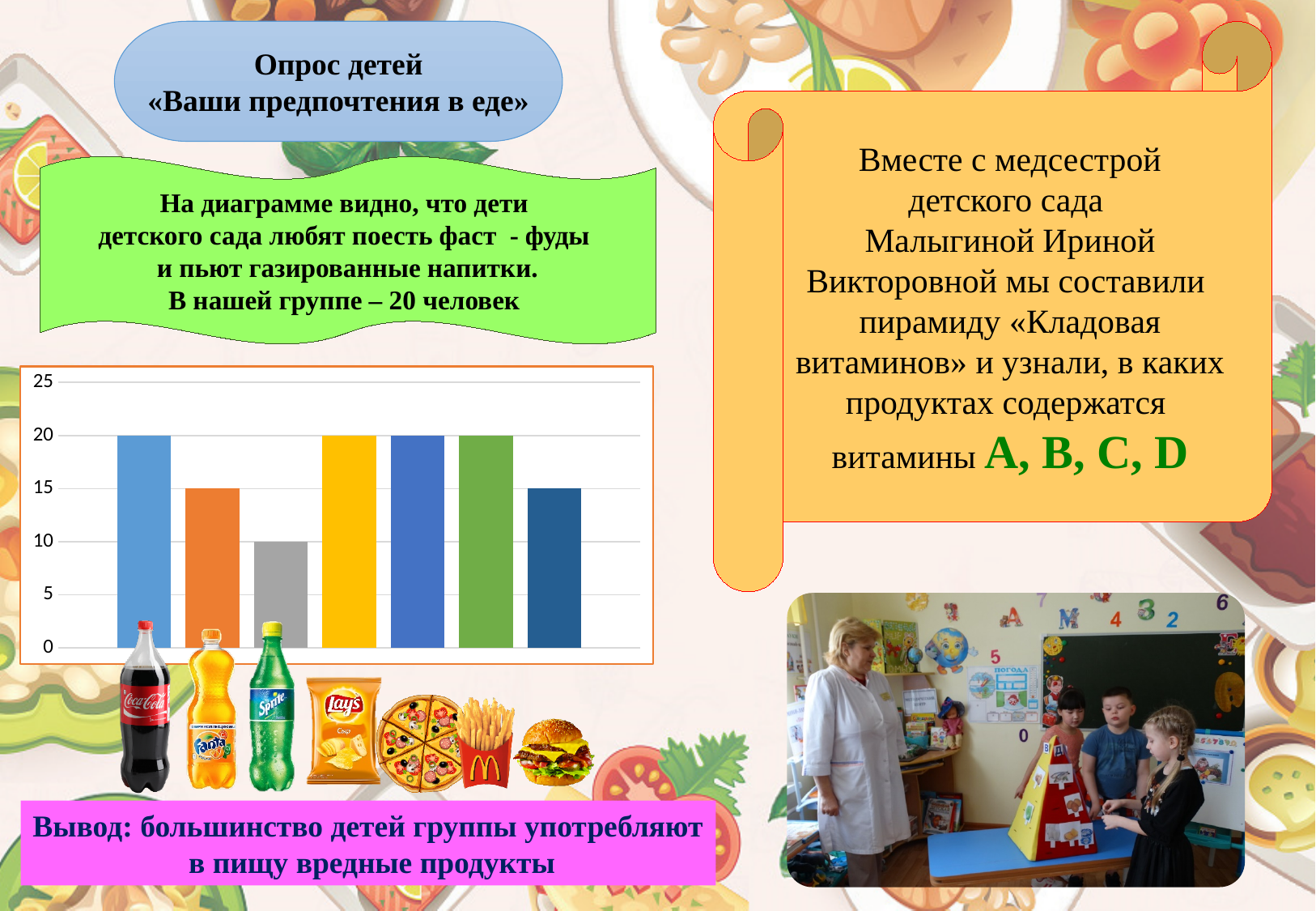
Which is larger, the orange bar or the grey bar? the orange bar What value does the second (orange) bar reach? 15 What value does the last (dark blue) bar on the right reach? 15 Which bar is the lowest in the chart? the third (grey) bar Is the value of the grey bar greater or less than 15? less How many bars does the chart contain? 7 What is the difference between the first (blue) bar and the third (grey) bar? 10 What value does the yellow bar reach? 20 What value does the first (blue) bar on the left reach? 20 What value does the third (grey) bar reach? 10 What is the highest value shown on the vertical axis? 25 What kind of chart is shown on the slide? bar chart